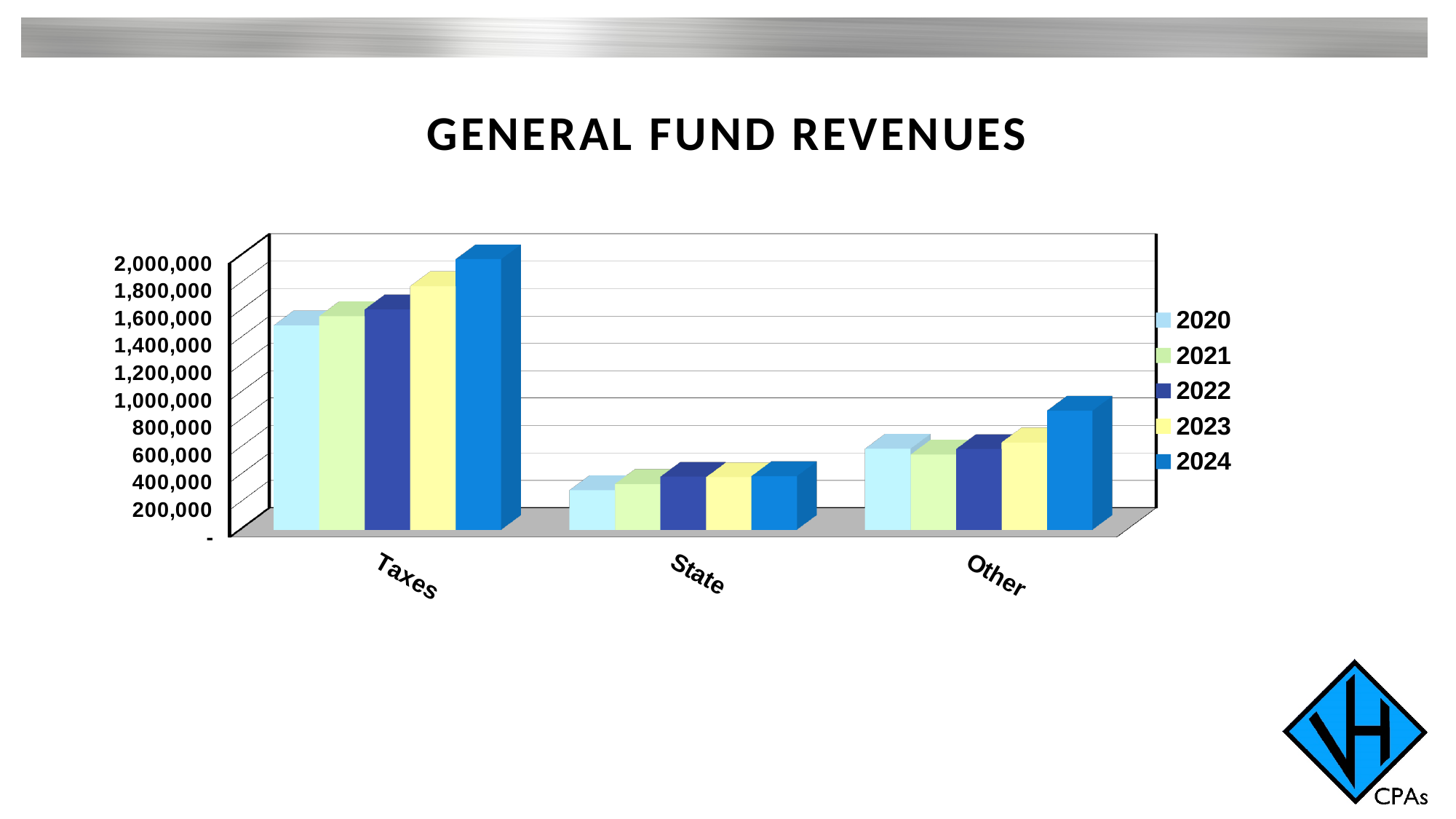
Which category has the lowest revenue in 2020? State Is the value for Taxes in 2024 greater or less than 1,800,000? greater What kind of chart is shown on the slide? bar chart What is the title of the chart? GENERAL FUND REVENUES How many categories are shown on the x axis? 3 Which category has the highest revenue in 2024? Taxes How many series does the legend list? 5 Which year has the highest value for Taxes? 2024 Is the value for Other in 2024 greater or less than 600,000? greater Is the value for State in 2020 greater or less than 600,000? less Do the Taxes values rise or fall from 2020 to 2024? rise Which is larger in 2024, the value for Other or the value for State? Other